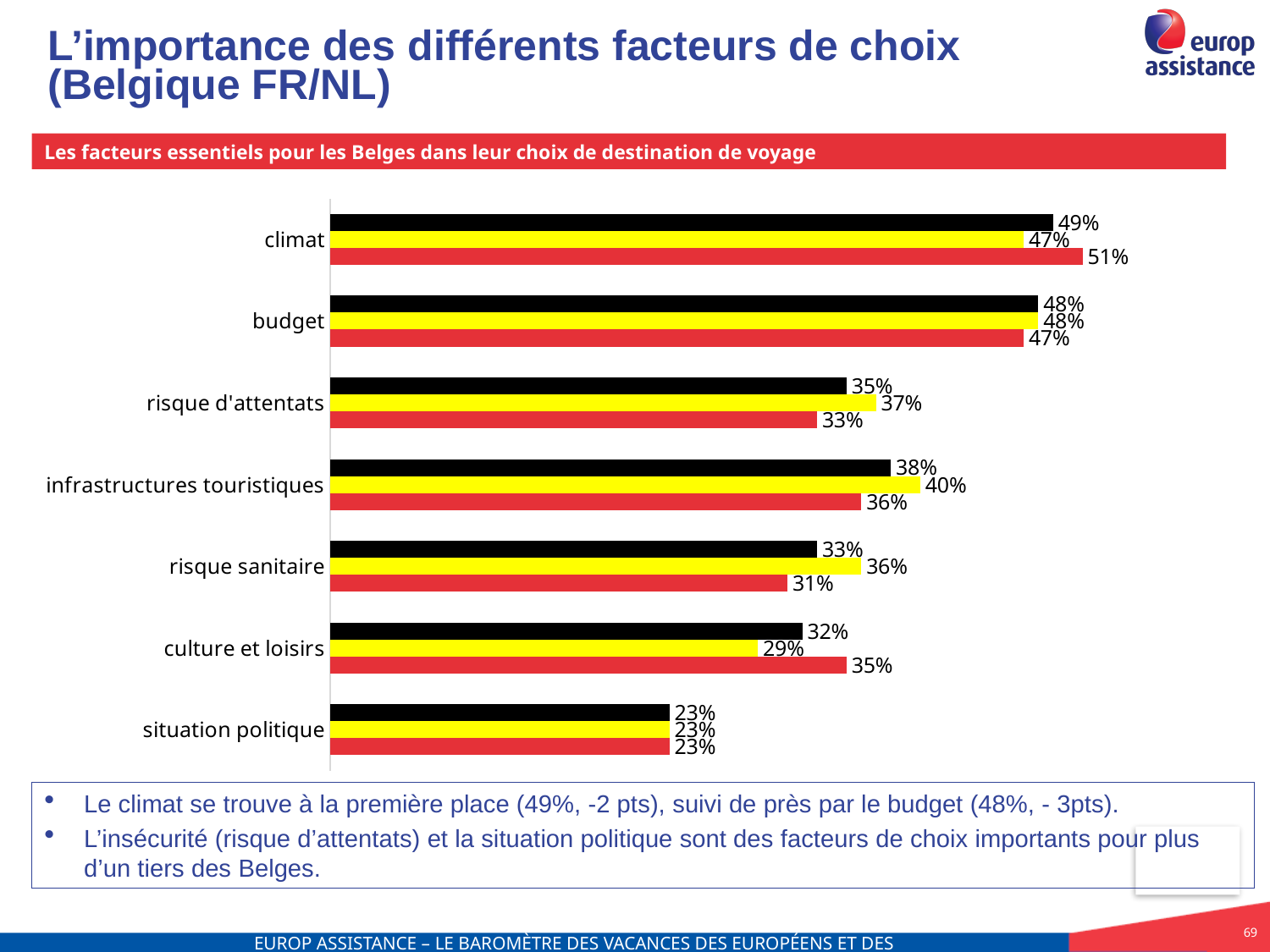
What colours are the three bars shown for each category? black, yellow and red What is the value of the black bar for climat? 49% How many categories are shown on the chart? 7 What is the value of the red bar for culture et loisirs? 35% What is the value of the red bar for risque sanitaire? 31% Which category has the highest value for the red bars? climat Which is larger for culture et loisirs, the black bar or the yellow bar? the black bar What is the value of the yellow bar for infrastructures touristiques? 40% What kind of chart is shown on the slide? bar chart What is the difference between the red bar and the yellow bar for climat? 4% Which category has the lowest value for the black bars? situation politique What is the difference between the yellow bar and the black bar for risque sanitaire? 3%